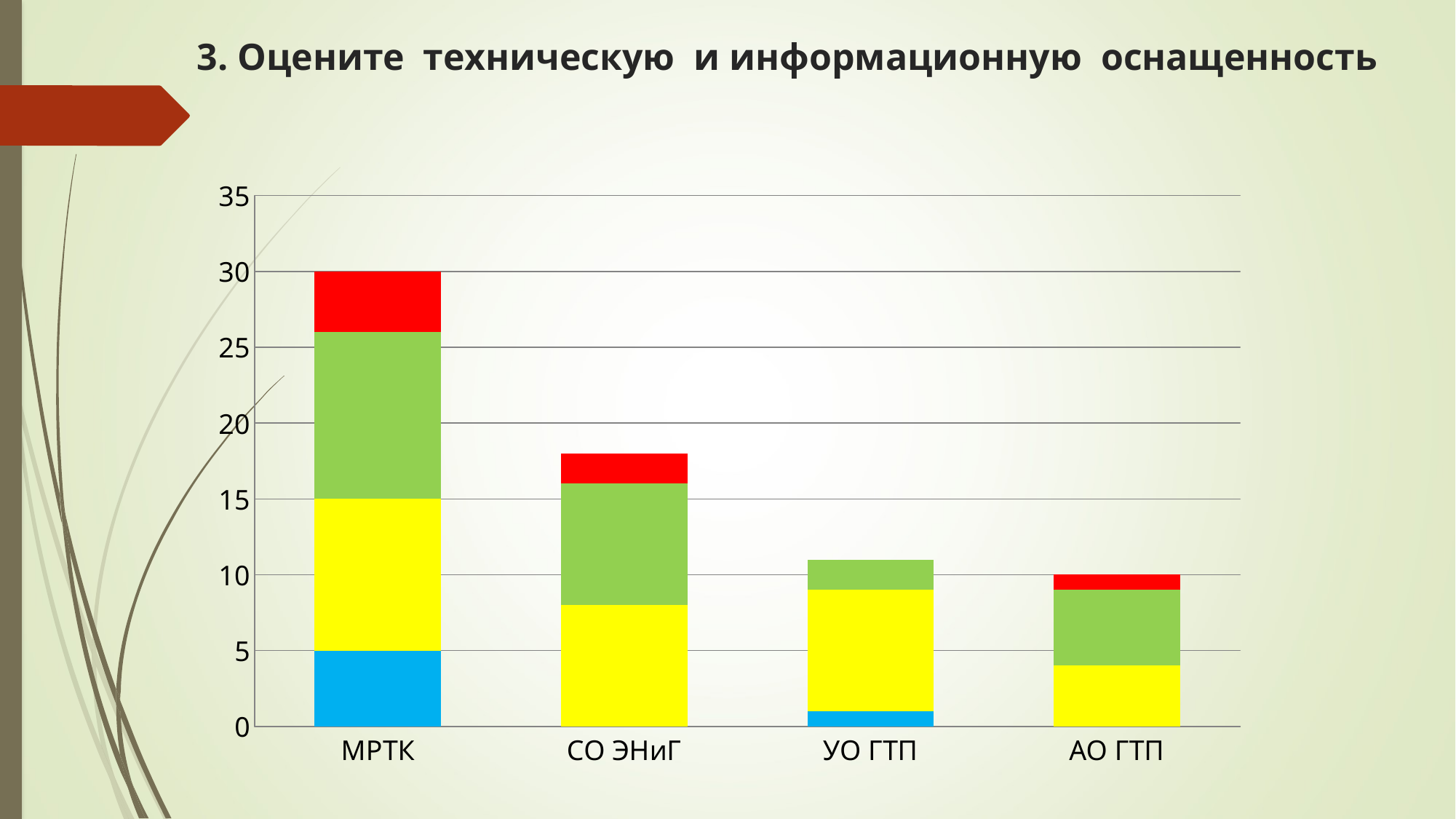
How many categories are shown on the x axis of the chart? 4 Is the total value for УО ГТП greater or less than 15? less Which stacked bar is taller, МРТК or СО ЭНиГ? МРТК Is the total value for СО ЭНиГ greater or less than 15? greater What kind of chart is shown on the slide? Stacked bar chart What is the title of the slide containing the chart? 3. Оцените техническую и информационную оснащенность Is the total value for СО ЭНиГ greater or less than 20? less Do the total bar heights rise or fall from left to right along the x axis? Fall Which category has the tallest stacked bar? МРТК Which category has the shortest stacked bar? АО ГТП What is the total height of the stacked bar for МРТК? 30 What is the total height of the stacked bar for АО ГТП? 10